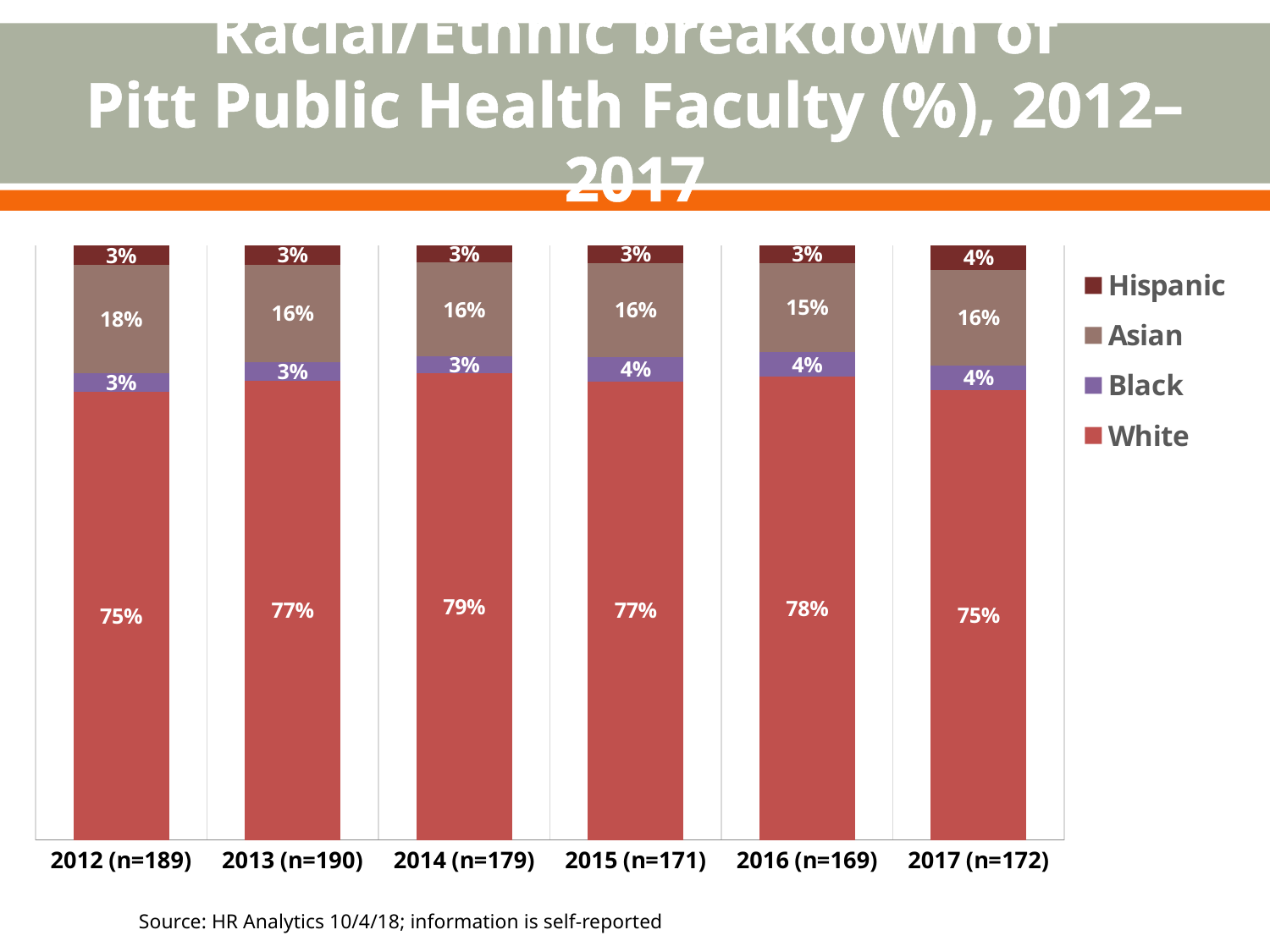
In which year was the White share of faculty highest? 2014 (n=179) By how many percentage points did the Asian share fall from 2012 to 2016? 3 percentage points How many racial/ethnic groups does the legend list? 4 What percentage of Pitt Public Health faculty was White in 2014? 79% What type of chart is shown on the slide? Stacked bar chart In which year was the Asian share of faculty lowest? 2016 (n=169) How many years are shown on the x axis? 6 What percentage of faculty was Asian in 2012? 18% Does the Asian share of faculty rise or fall from 2012 to 2016? Fall What is the Hispanic share of faculty in 2017? 4% What is the Black share of faculty in 2016? 4% Which year had a larger White share, 2013 or 2016? 2016